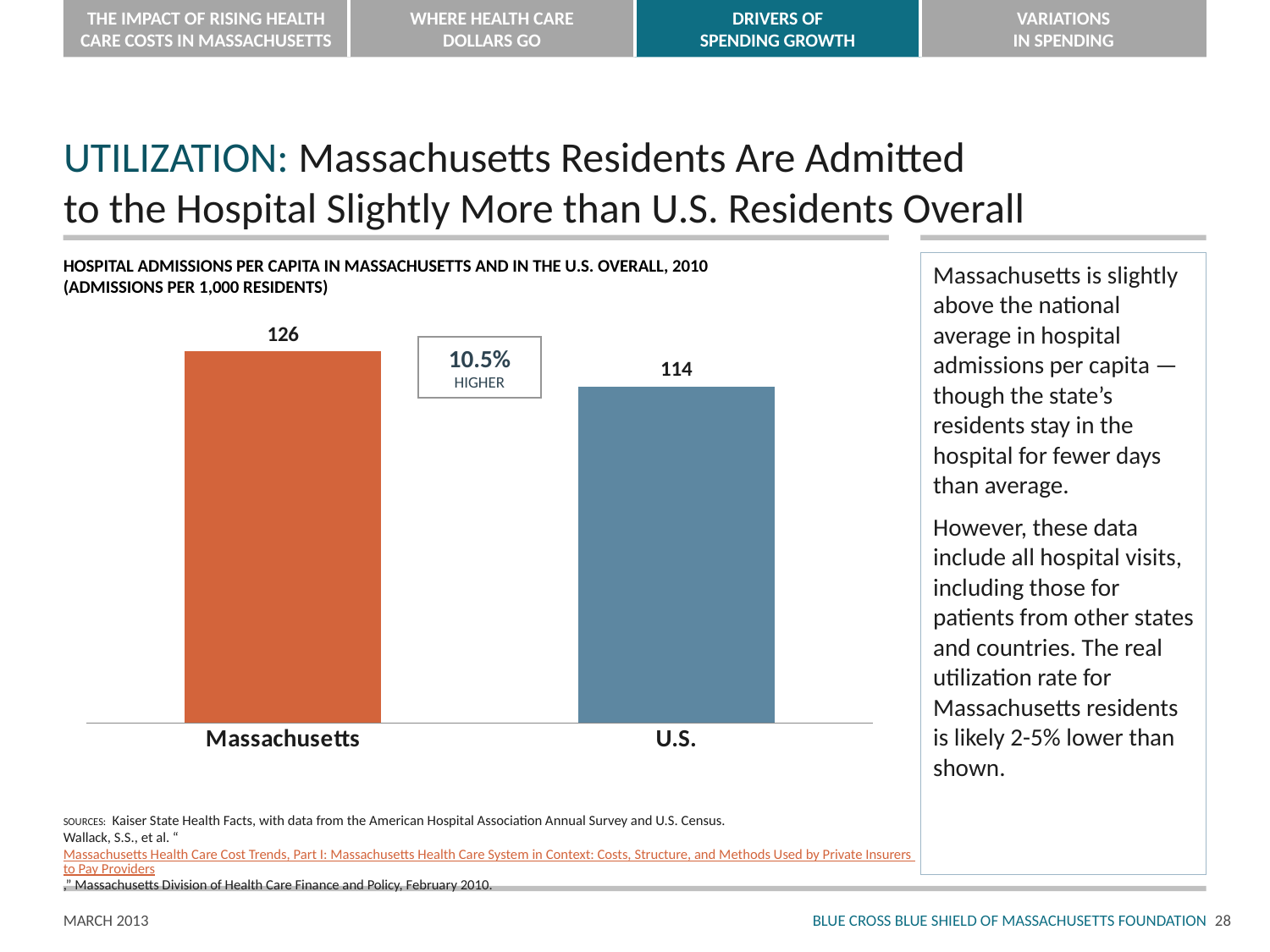
What unit are the chart's values expressed in, according to the chart title? Admissions per 1,000 residents What kind of chart is shown on the slide? Bar chart According to the callout on the chart, by what percentage is Massachusetts higher than the U.S.? 10.5% What is the difference between the values for Massachusetts and U.S.? 12 How many categories are shown in the chart? 2 Which category has the lowest value? U.S. What is the value for U.S.? 114 What is the value for Massachusetts? 126 Which category has the highest value? Massachusetts Which is larger, the value for Massachusetts or the value for U.S.? Massachusetts